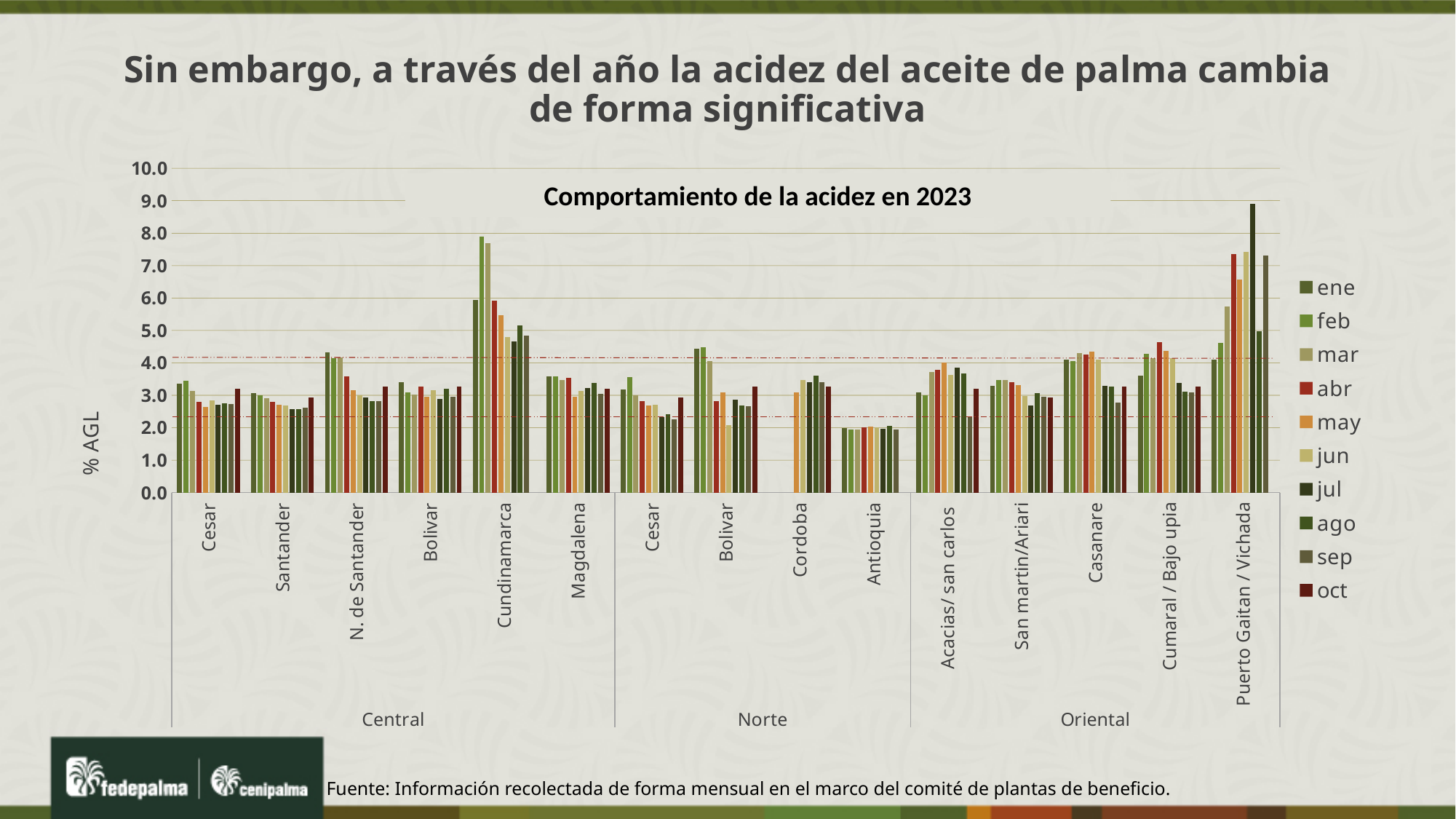
What is the label of the vertical axis of the chart? % AGL Is the value for feb at Antioquia greater or less than 3.0? less What kind of chart is shown on the slide? bar chart Which is larger, the feb value for Cundinamarca or the feb value for Magdalena? Cundinamarca How many plant locations (categories) are shown along the x axis of the chart? 15 How many regional groups (Central, Norte, Oriental) are the categories divided into? 3 Which location has the single tallest bar in the chart? Puerto Gaitan / Vichada Is the value for ago (August) at Puerto Gaitan / Vichada greater or less than 8.0? less How many series does the legend of the chart list? 10 What is the title of the chart? Comportamiento de la acidez en 2023 Is the value for jun at Cordoba greater or less than 3.0? greater